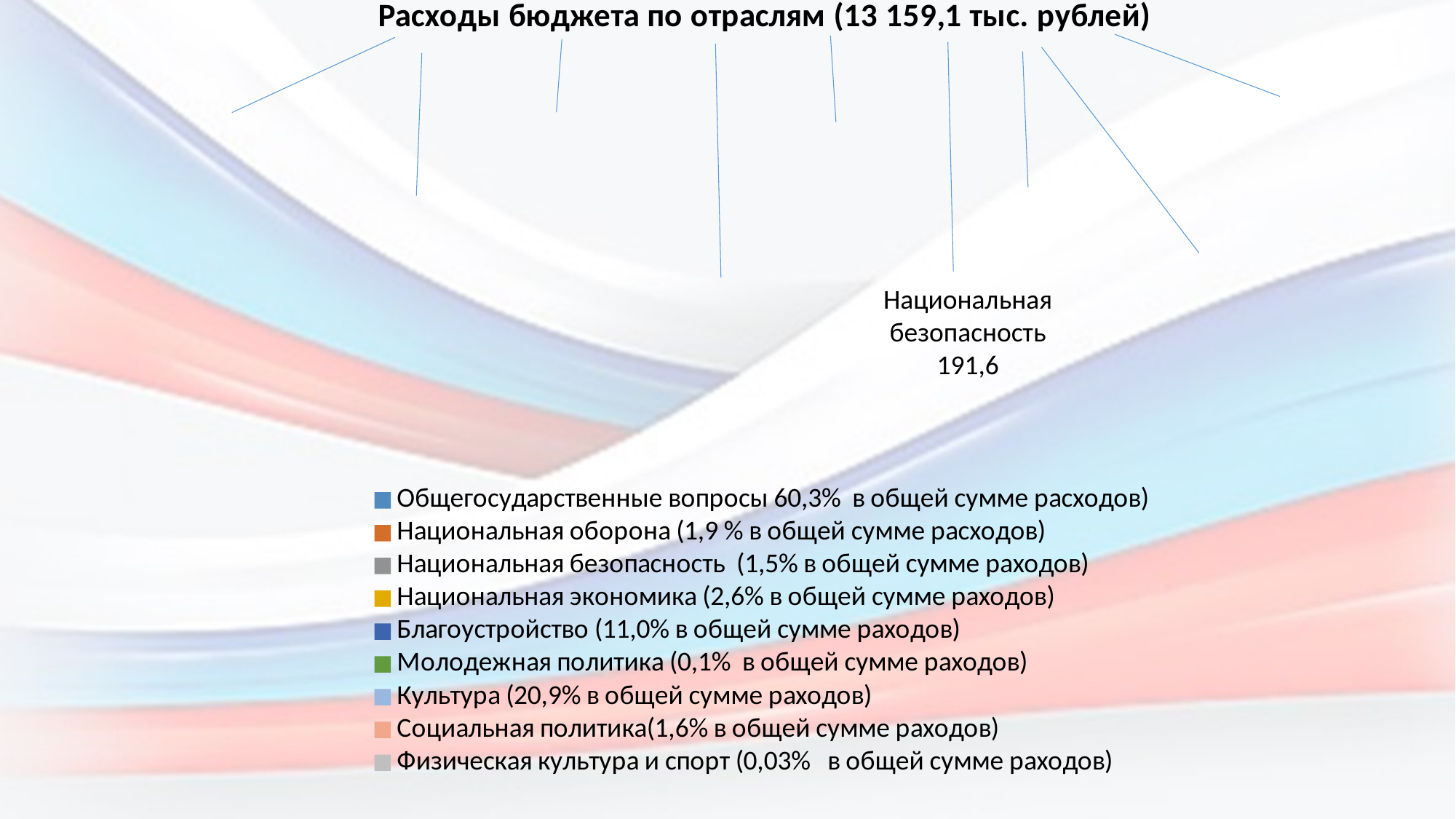
How many entries does the chart legend list? 9 Which category has the smallest share of expenditure according to the legend? Физическая культура и спорт What share of total expenditure does Национальная оборона account for, according to the legend? 1,9 % What share of total expenditure does Благоустройство account for, according to the legend? 11,0% What total budget expenditure is stated in the chart title? 13 159,1 тыс. рублей What share of total expenditure does Национальная безопасность account for, according to the legend? 1,5% What is the difference in percentage points between the shares of Общегосударственные вопросы and Культура? 39,4 Which has a larger share of expenditure, Культура or Благоустройство? Культура What is the title of the chart? Расходы бюджета по отраслям (13 159,1 тыс. рублей) What value is shown in the data label for Национальная безопасность? 191,6 Which category has the largest share of expenditure according to the legend? Общегосударственные вопросы